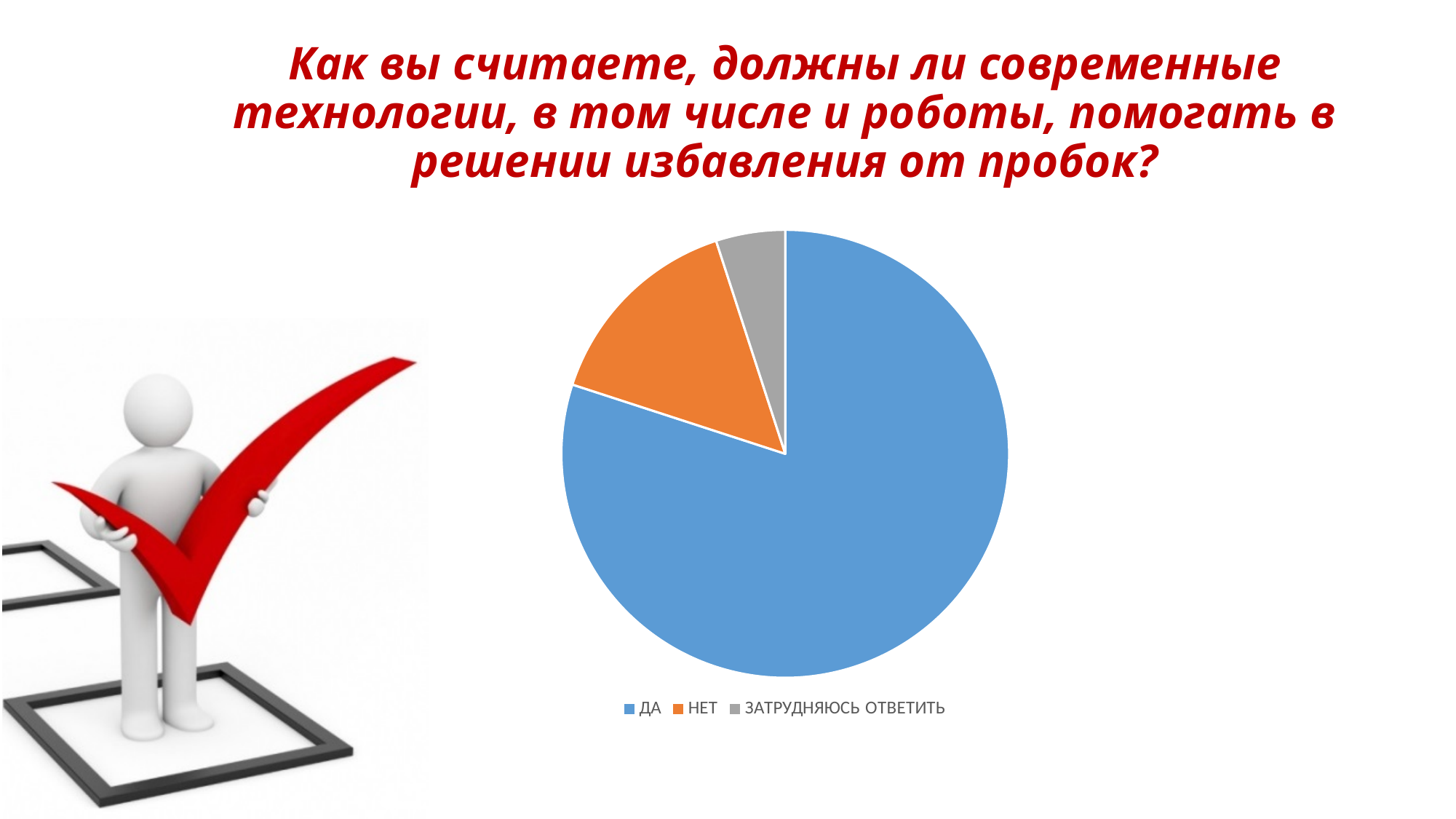
How many entries does the legend of the pie chart list? 3 Which category has the smallest slice in the pie chart? ЗАТРУДНЯЮСЬ ОТВЕТИТЬ Which legend entry is shown in orange in the pie chart? НЕТ What kind of chart is shown on the slide? pie chart Does the ДА slice take up more or less than half of the pie chart? more Which slice is larger in the pie chart, ДА or НЕТ? ДА What colour is the ДА slice in the pie chart? blue Which slice is larger in the pie chart, НЕТ or ЗАТРУДНЯЮСЬ ОТВЕТИТЬ? НЕТ Which category has the largest slice in the pie chart? ДА How many slices does the pie chart have? 3